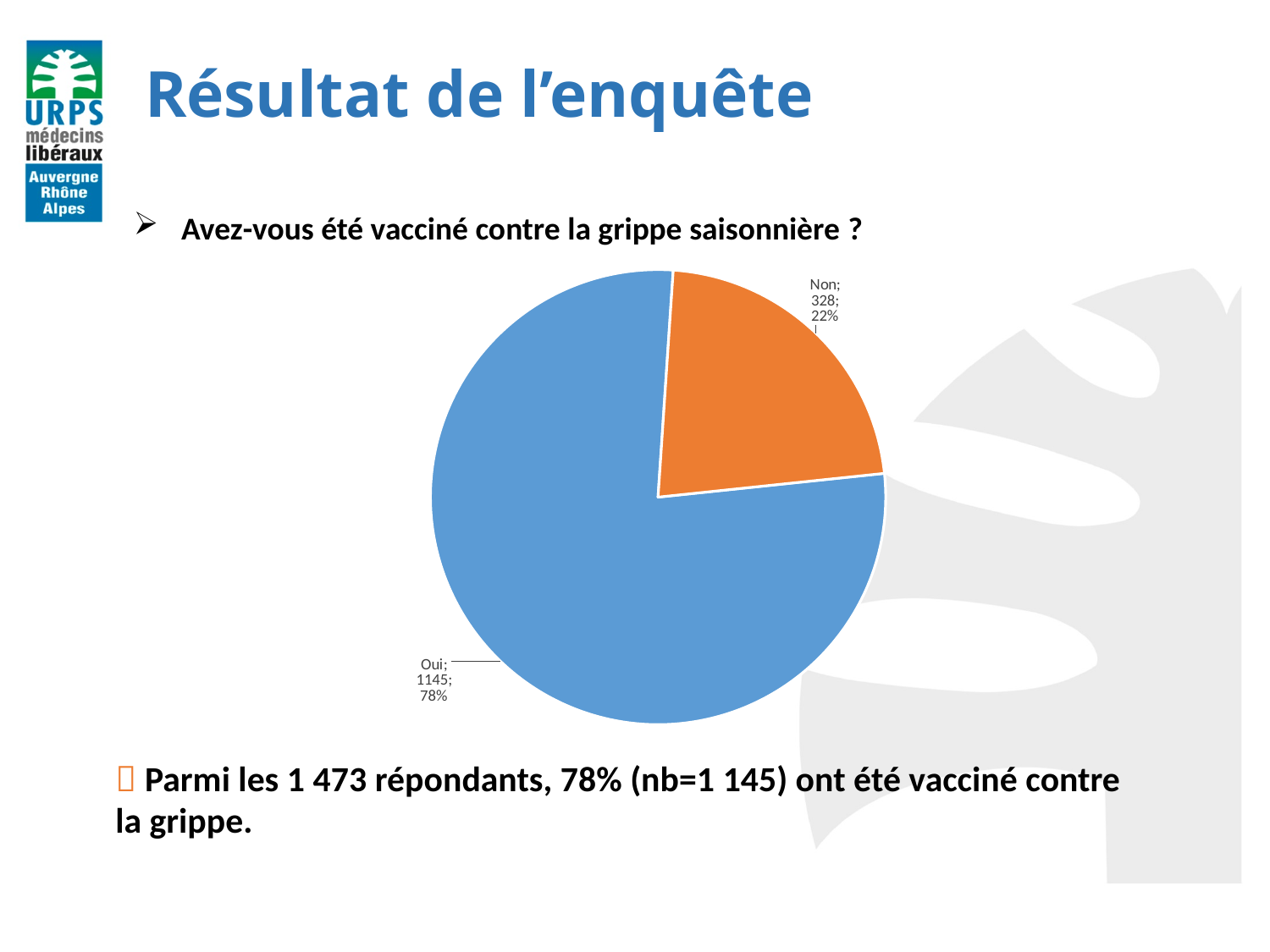
What is the total of the two slices in the pie chart? 1473 What share of the pie does the "Non" slice represent? 22% Which slice is the smallest in the pie chart? Non How many slices does the pie chart have? 2 What colour is the "Non" slice in the pie chart? orange What is the value for "Oui" in the pie chart? 1145 Which is larger, the value for "Oui" or the value for "Non"? Oui What share of the pie does the "Oui" slice represent? 78% Which slice is the largest in the pie chart? Oui What is the difference between the "Oui" and "Non" values? 817 What is the value for "Non" in the pie chart? 328 What kind of chart is shown on the slide? pie chart